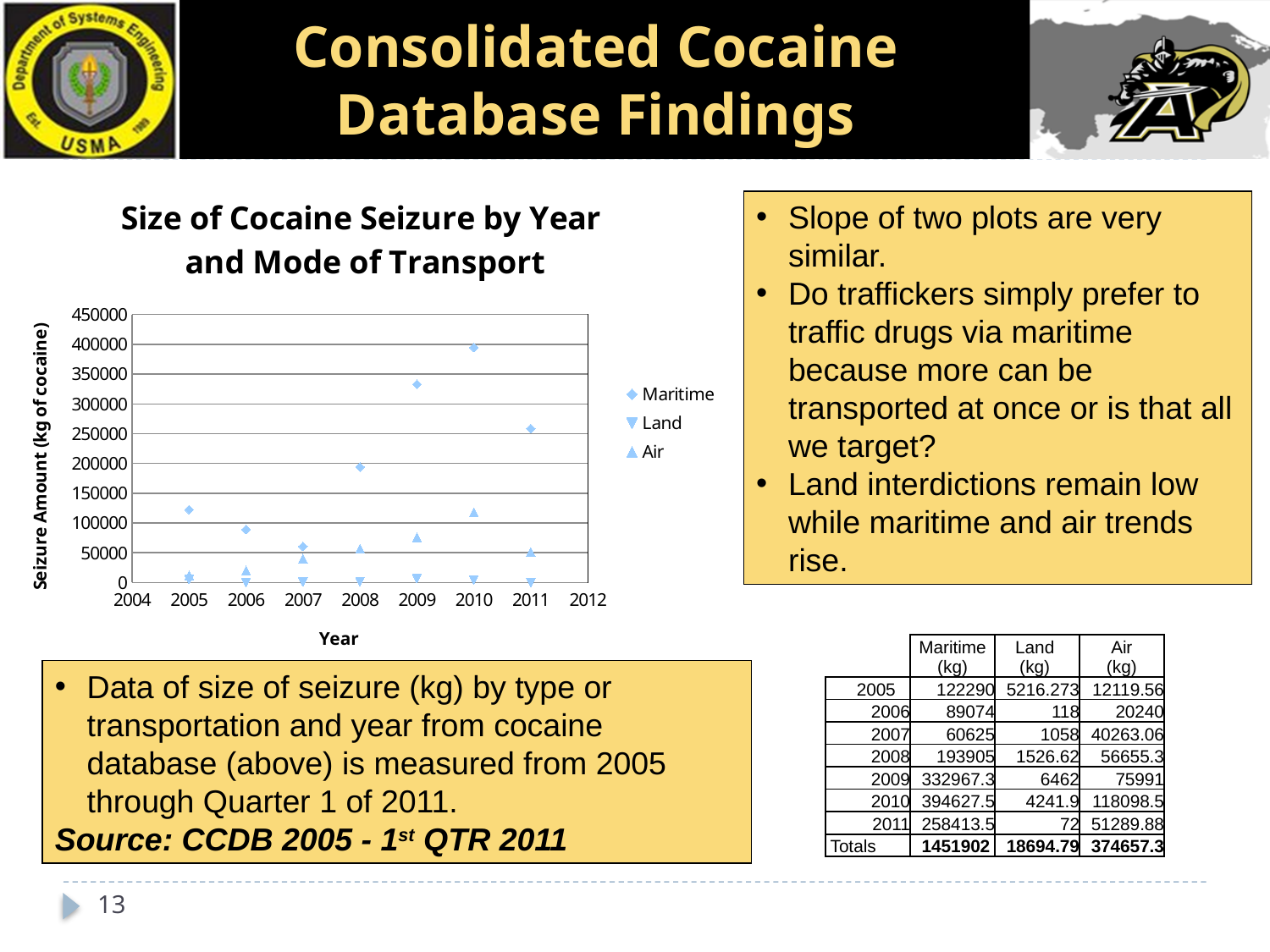
Is the Maritime value for 2009 greater or less than 300000? greater In 2008, which is larger, the Maritime value or the Air value? Maritime Is the Maritime value for 2007 greater or less than 100000? less What is the difference between the Maritime seizure amounts for 2010 and 2009? 61660.2 What kind of chart is shown on the slide? scatter chart How many series does the chart legend list? 3 In which year does the Maritime series reach its highest value? 2010 What are the three series named in the chart legend? Maritime, Land, Air What is the title of the chart? Size of Cocaine Seizure by Year and Mode of Transport Which series has the lowest values across all years plotted? Land How many years of data are plotted for each series? 7 What is the Maritime seizure amount (kg) for 2010? 394627.5